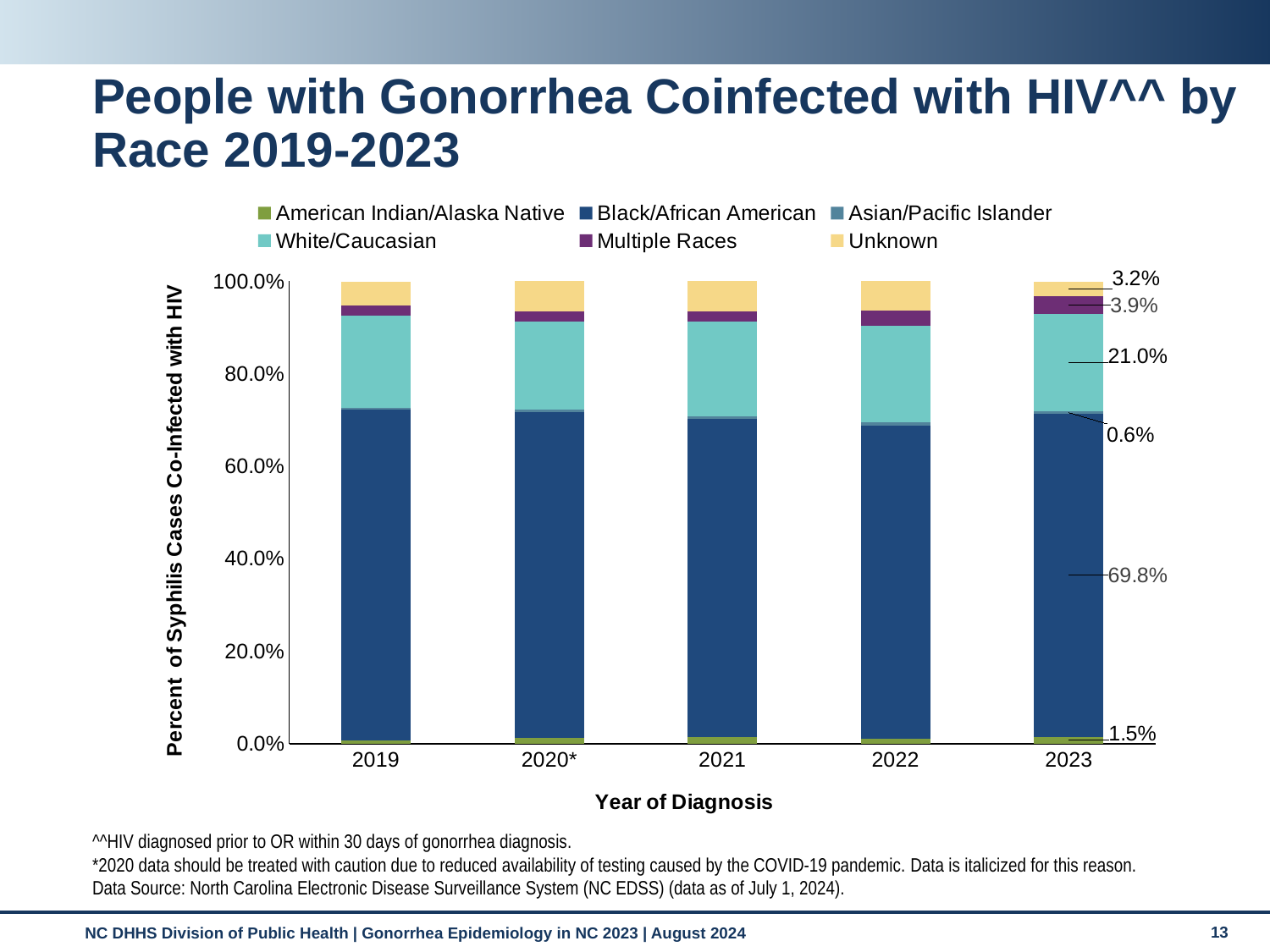
In 2023, which is larger: Multiple Races or Unknown? Multiple Races What percentage of the 2023 bar is Black/African American? 69.8% What is the Unknown value labelled for 2023? 3.2% Which race group has the largest share of the 2023 bar? Black/African American What kind of chart is shown on the slide? Stacked bar chart What is the White/Caucasian value for 2023? 21.0% Is the Black/African American share of the 2019 bar greater or less than 60.0%? greater What is the difference between the Black/African American and White/Caucasian values in 2023? 48.8 percentage points How many years of diagnosis are shown on the x axis? 5 Which race group has the smallest share of the 2023 bar? Asian/Pacific Islander How many race groups does the legend list? 6 What is the Asian/Pacific Islander value for 2023? 0.6%